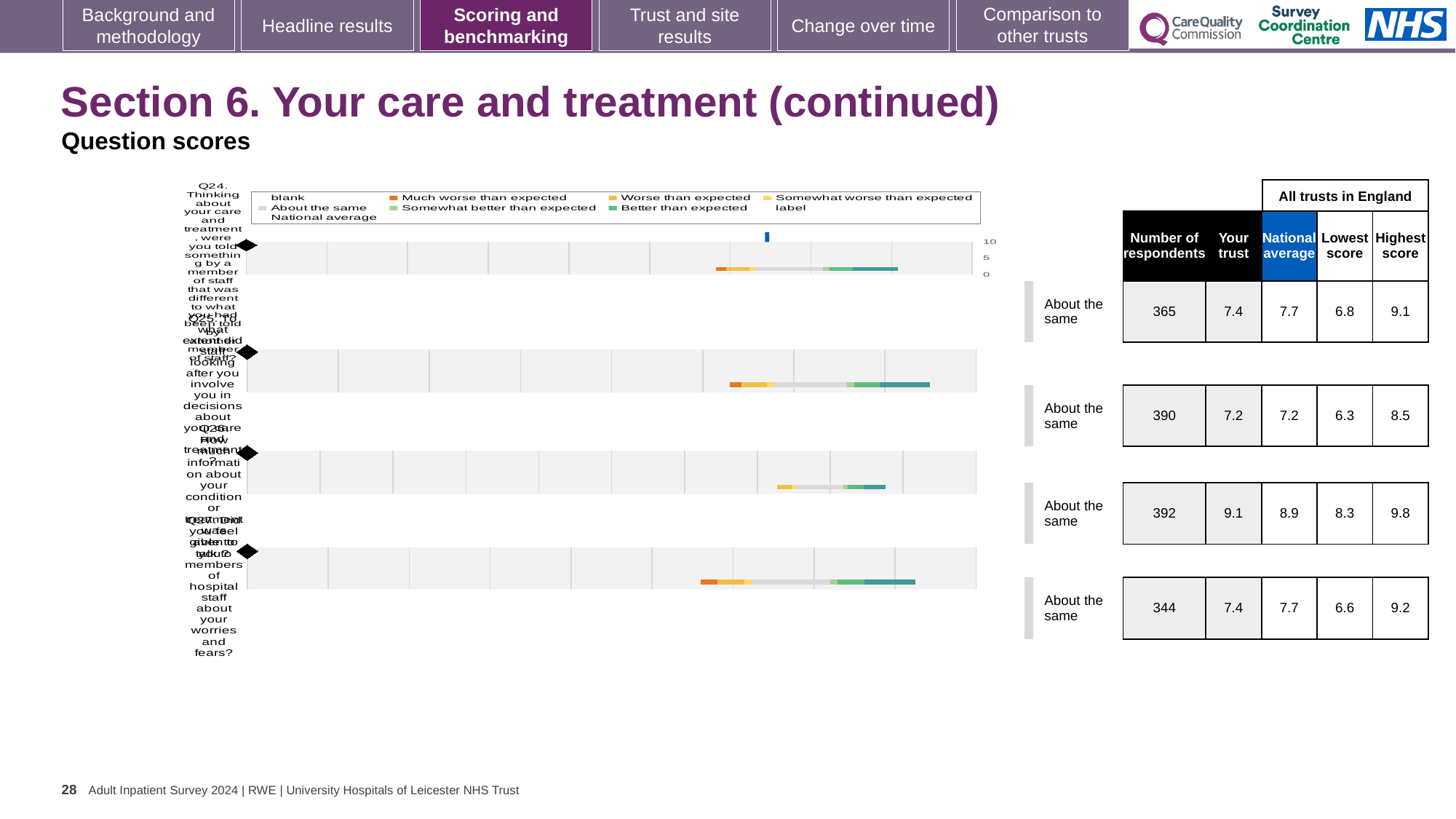
For the first chart (Q24), what is the number of respondents shown? 365 What benchmark category is shown next to each of the four question charts? About the same For the third chart (Q26), what is the national average score? 8.9 What colour represents 'Much worse than expected' in the chart legend? orange How many entries does the chart legend list? 9 What kind of chart is used to show the question scores on this slide? bar chart For the third chart (Q26), is the 'Your trust' score higher or lower than the national average? higher Which question chart has the highest 'Your trust' score? Q26 How many question charts (Q24 to Q27) are shown on the slide? 4 For the bottom chart (Q27, talking to staff about worries and fears), what is the 'Your trust' score? 7.4 For the second chart (Q25), what is the highest score among all trusts in England? 8.5 For the first chart (Q24), what is the difference between the highest score and the lowest score? 2.3